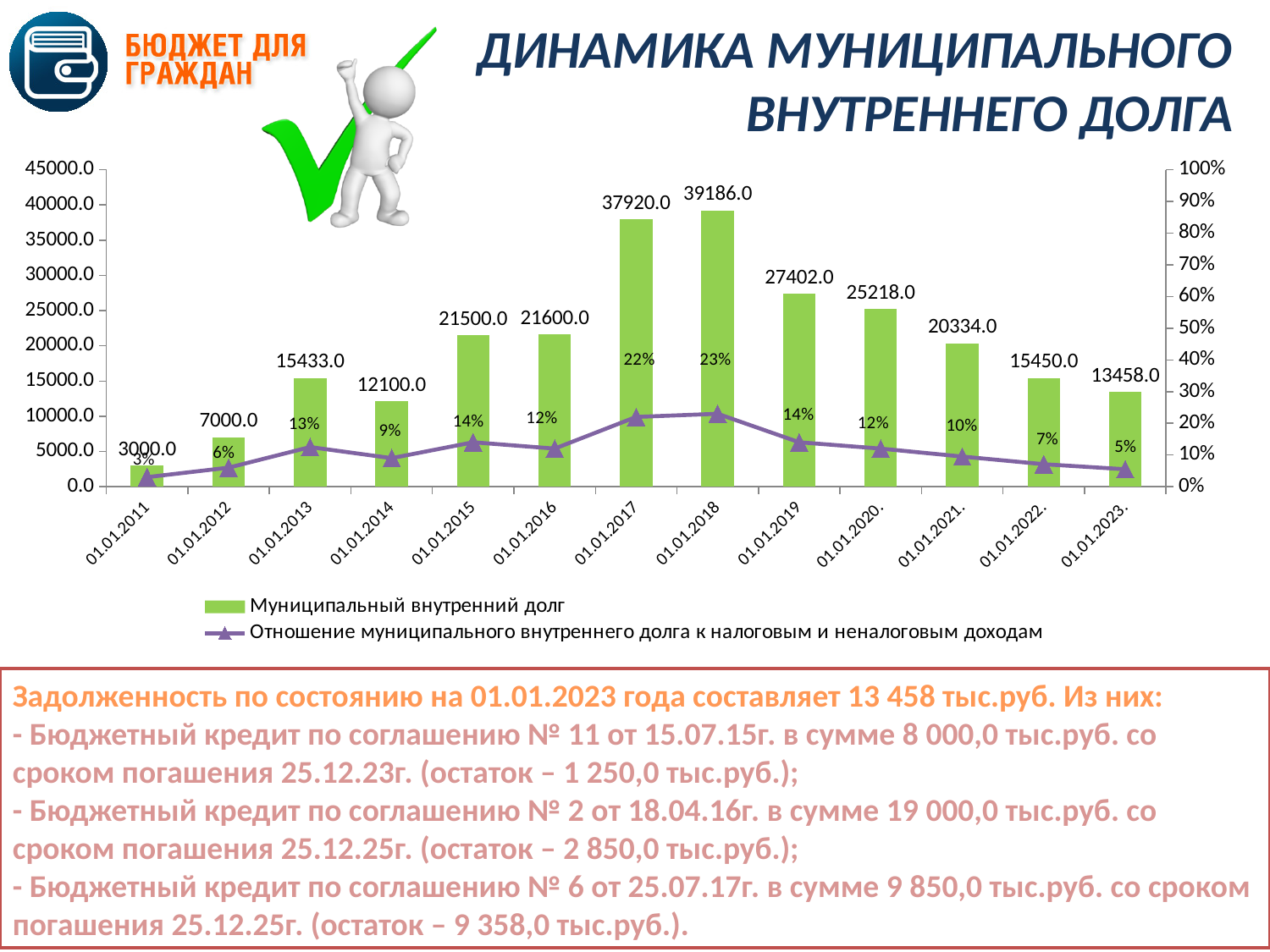
What is the value of Муниципальный внутренний долг for 01.01.2023? 13458.0 What is the value of Муниципальный внутренний долг for 01.01.2018? 39186.0 What is the difference between the Отношение муниципального внутреннего долга к налоговым и неналоговым доходам values for 01.01.2018 and 01.01.2023? 18% What is the title of the chart? ДИНАМИКА МУНИЦИПАЛЬНОГО ВНУТРЕННЕГО ДОЛГА How many series does the legend list? 2 Which is larger, the Муниципальный внутренний долг value for 01.01.2019 or for 01.01.2020? 01.01.2019 Which date has the highest value of Муниципальный внутренний долг? 01.01.2018 What is the value of Отношение муниципального внутреннего долга к налоговым и неналоговым доходам for 01.01.2017? 22% What is the difference between the Муниципальный внутренний долг values for 01.01.2018 and 01.01.2017? 1266.0 How many dates are shown on the x axis of the chart? 13 Which date has the lowest value of Муниципальный внутренний долг? 01.01.2011 Does the Муниципальный внутренний долг value rise or fall from 01.01.2018 to 01.01.2023? fall